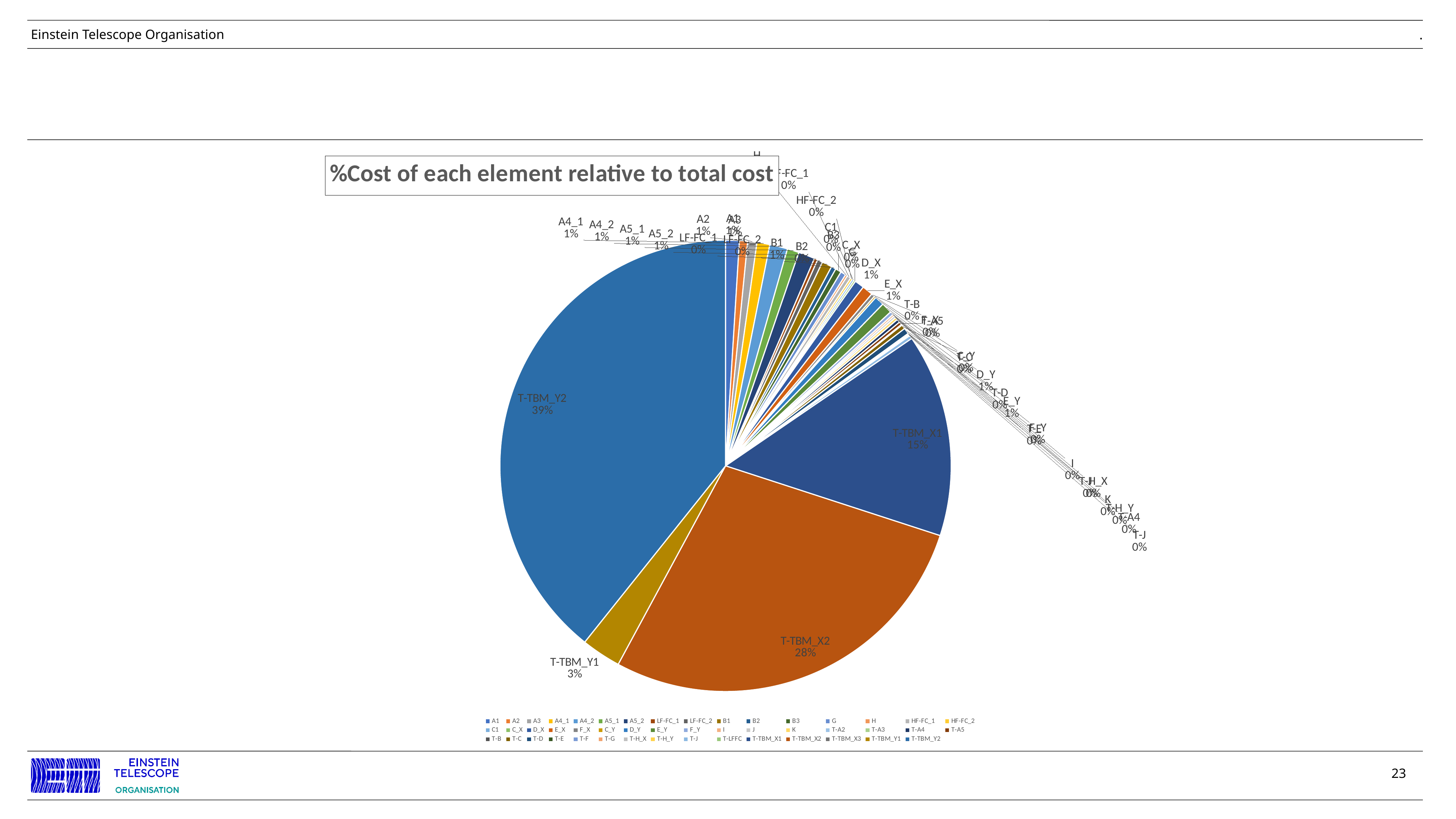
What is the percentage shown for T-TBM_Y1? 3% Which element has the largest share of the total cost? T-TBM_Y2 By how many percentage points does the share of T-TBM_Y2 exceed the share of T-TBM_X2? 11 What kind of chart is shown on the slide? pie chart What is the percentage shown for A4_1? 1% What share of the total cost does T-TBM_X1 account for? 15% What share of the total cost does T-TBM_X2 account for? 28% Which is larger, the share for T-TBM_X2 or the share for T-TBM_X1? T-TBM_X2 What is the title of the chart? %Cost of each element relative to total cost What is the percentage shown for T-J? 0% What share of the total cost does T-TBM_Y2 account for? 39% What is the combined share of T-TBM_Y2 and T-TBM_X2? 67%